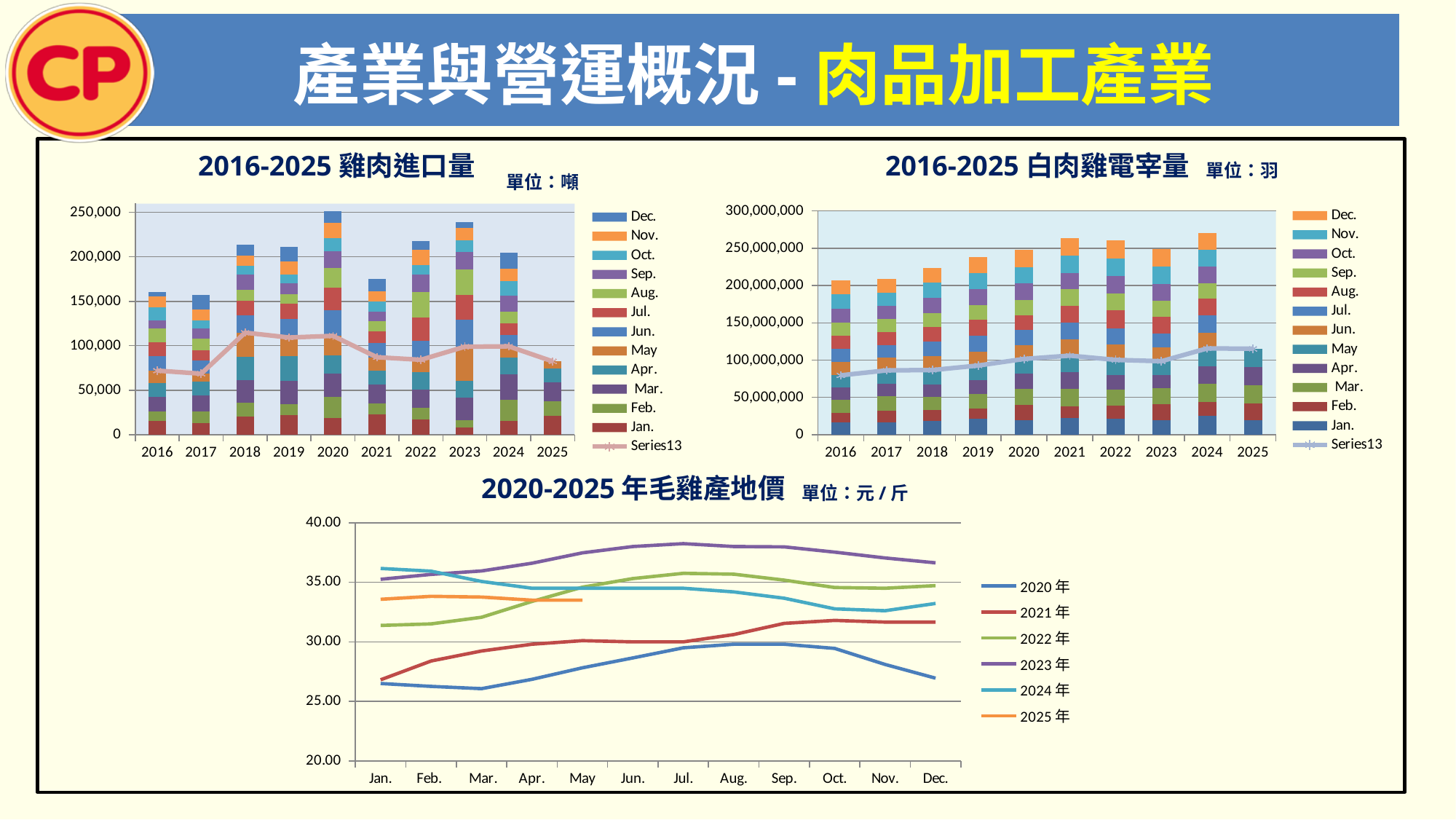
In the 2016-2025 雞肉進口量 chart, is the total for 2020 greater or less than 200,000? greater In the 2016-2025 白肉雞電宰量 chart, is the total for 2025 greater or less than 150,000,000? less In the 2016-2025 白肉雞電宰量 chart, which year has the tallest stacked bar? 2024 In the 2016-2025 白肉雞電宰量 chart, how many entries does the legend list? 13 What kind of chart is the 2020-2025 年毛雞產地價 chart? Line chart In the 2020-2025 年毛雞產地價 chart, how many series does the legend list? 6 In the 2016-2025 雞肉進口量 chart, which year has the tallest stacked bar? 2020 In the 2016-2025 白肉雞電宰量 chart, which year has the shortest stacked bar? 2025 In the 2020-2025 年毛雞產地價 chart, is the value for 2020 年 in Mar. greater or less than 30.00? less In the 2016-2025 雞肉進口量 chart, how many years are shown on the x axis? 10 In the 2016-2025 雞肉進口量 chart, which year has the shortest stacked bar? 2025 In the 2020-2025 年毛雞產地價 chart, which year's line is highest in Jul.? 2023 年